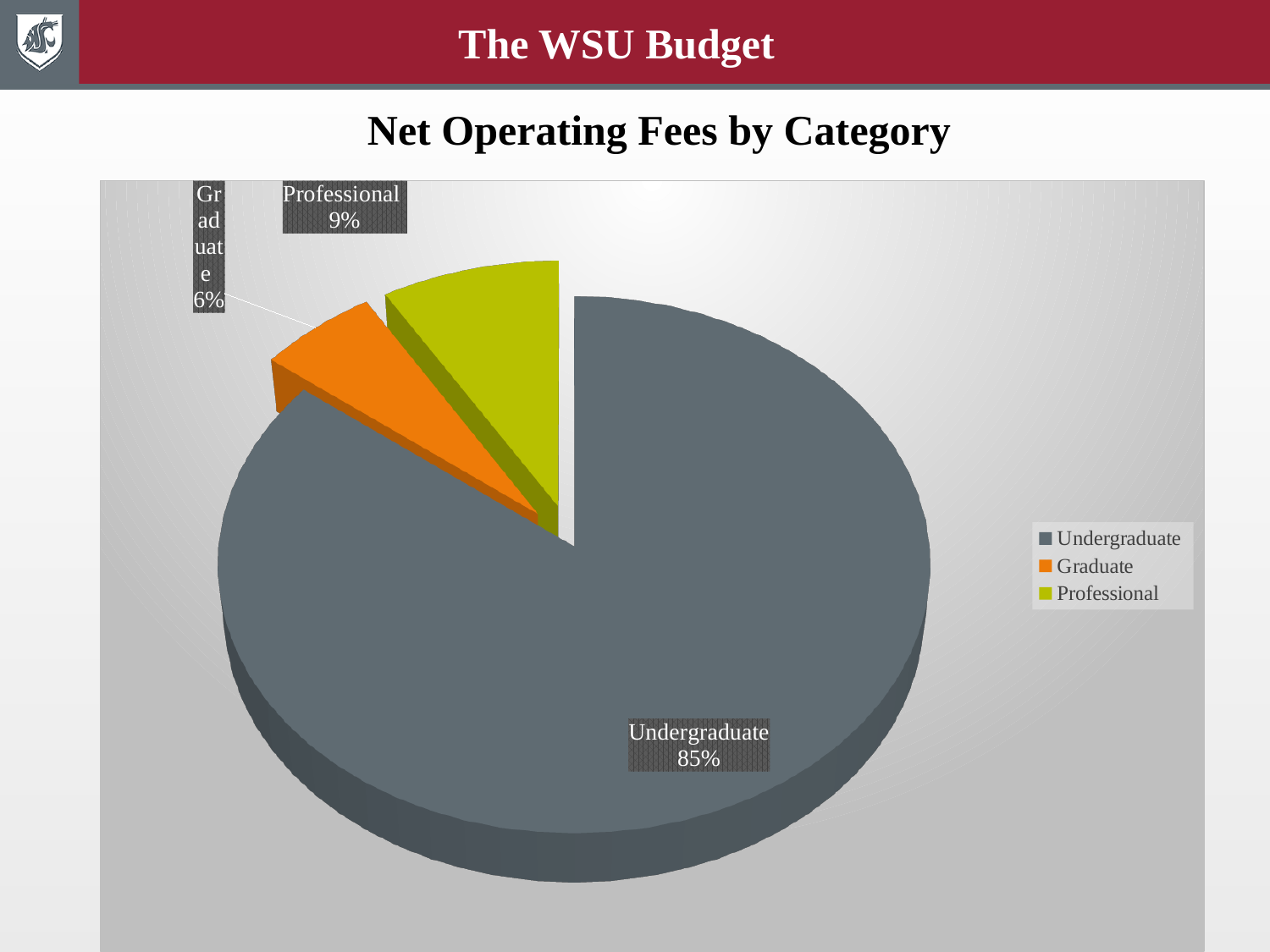
What is the title of the chart? Net Operating Fees by Category What share of net operating fees comes from Graduate? 6% What is the difference in percentage points between the Professional share and the Graduate share? 3 percentage points What share of net operating fees comes from Undergraduate? 85% Which category has the smallest share of net operating fees? Graduate Which is larger, the Professional share or the Graduate share? Professional What kind of chart is shown on the slide? Pie chart Which category has the largest share of net operating fees? Undergraduate Which colour represents the Graduate slice in the legend? Orange What is the difference in percentage points between the Undergraduate share and the Professional share? 76 percentage points What share of net operating fees comes from Professional? 9% How many categories does the pie chart show? 3